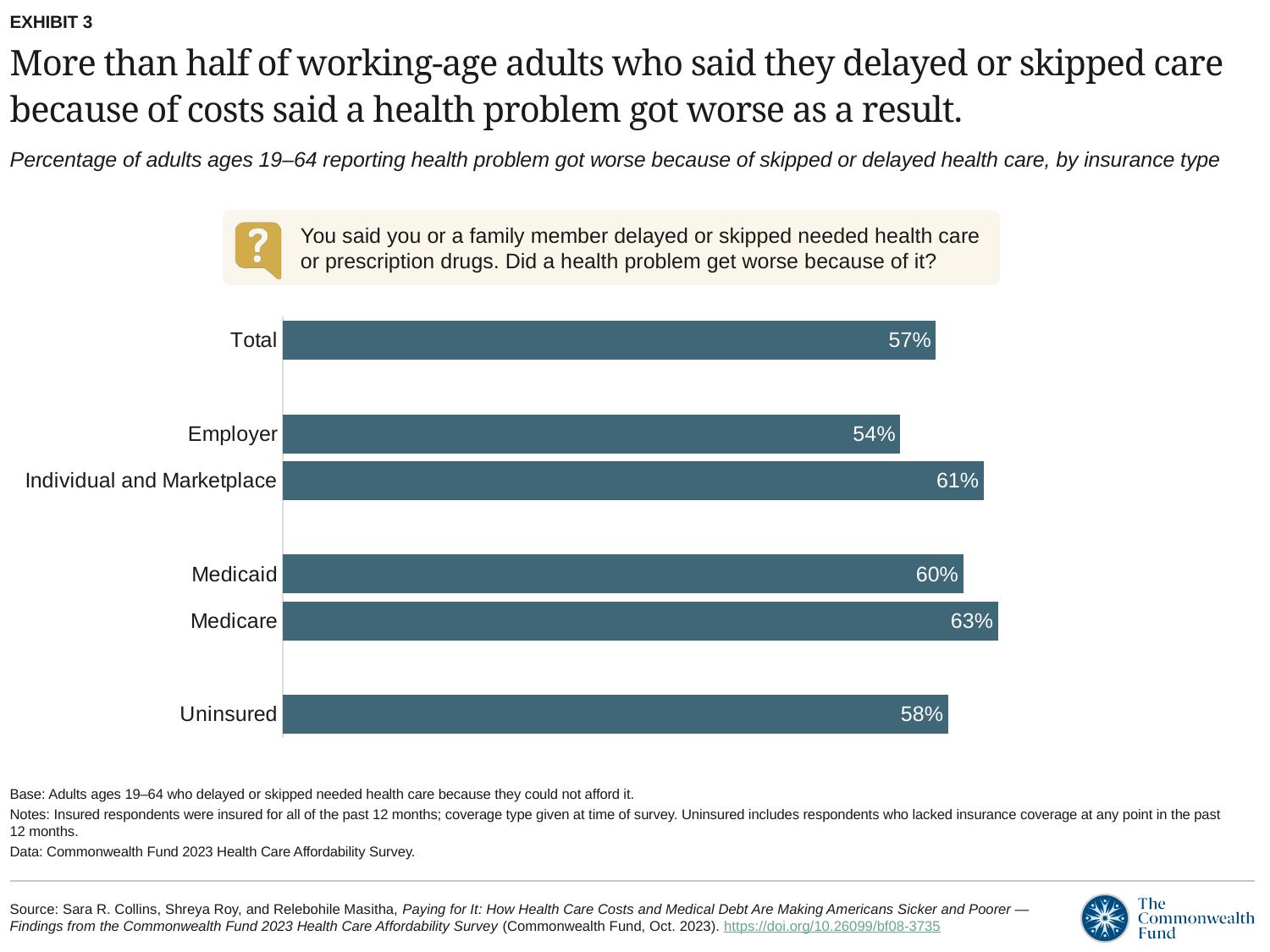
What percentage is shown for Employer? 54% What percentage is shown for Total? 57% What percentage is shown for Medicaid? 60% What percentage is shown for Uninsured? 58% Which insurance type has the lowest percentage? Employer What is the difference between the Medicare and Employer percentages? 9 percentage points How many bars are shown in the chart? 6 What kind of chart is shown on the slide? Bar chart Which is larger, the value for Medicaid or the value for Uninsured? Medicaid What percentage is shown for Individual and Marketplace? 61% Which insurance type has the highest percentage? Medicare What is the exhibit number shown at the top of the slide? Exhibit 3